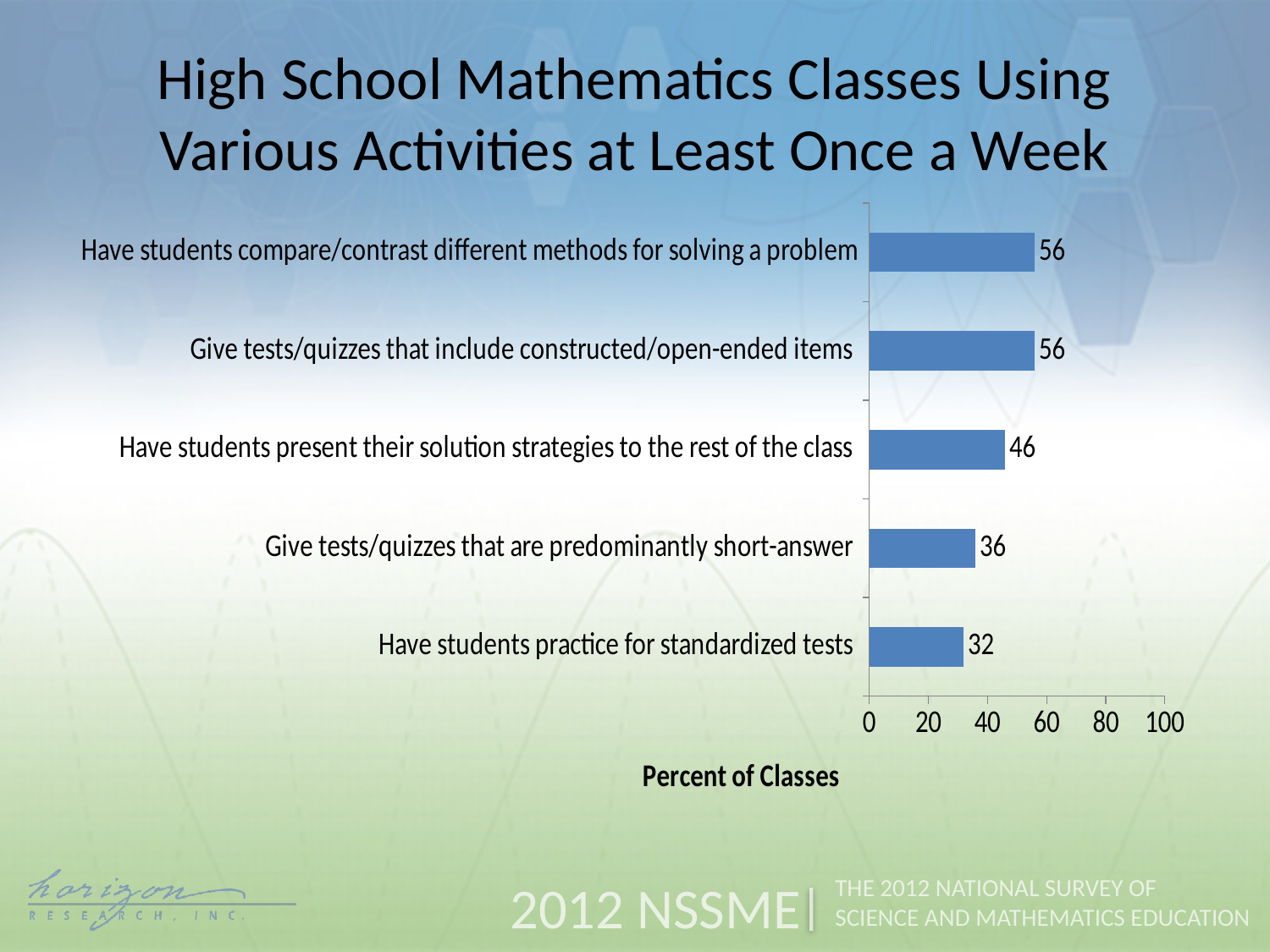
Is the value for 'Have students present their solution strategies to the rest of the class' greater or less than 40? greater How many activities are shown in the chart? 5 What is the value for 'Give tests/quizzes that are predominantly short-answer'? 36 What kind of chart is shown on the slide? bar chart What is the value for 'Have students present their solution strategies to the rest of the class'? 46 What is the label of the horizontal axis? Percent of Classes Which is larger: the value for 'Give tests/quizzes that include constructed/open-ended items' or the value for 'Give tests/quizzes that are predominantly short-answer'? Give tests/quizzes that include constructed/open-ended items What is the difference between the value for 'Have students present their solution strategies to the rest of the class' and the value for 'Have students practice for standardized tests'? 14 What is the maximum value shown on the horizontal axis? 100 What percent of classes have students compare/contrast different methods for solving a problem at least once a week? 56 Which activity has the lowest percent of classes? Have students practice for standardized tests What is the value for 'Have students practice for standardized tests'? 32